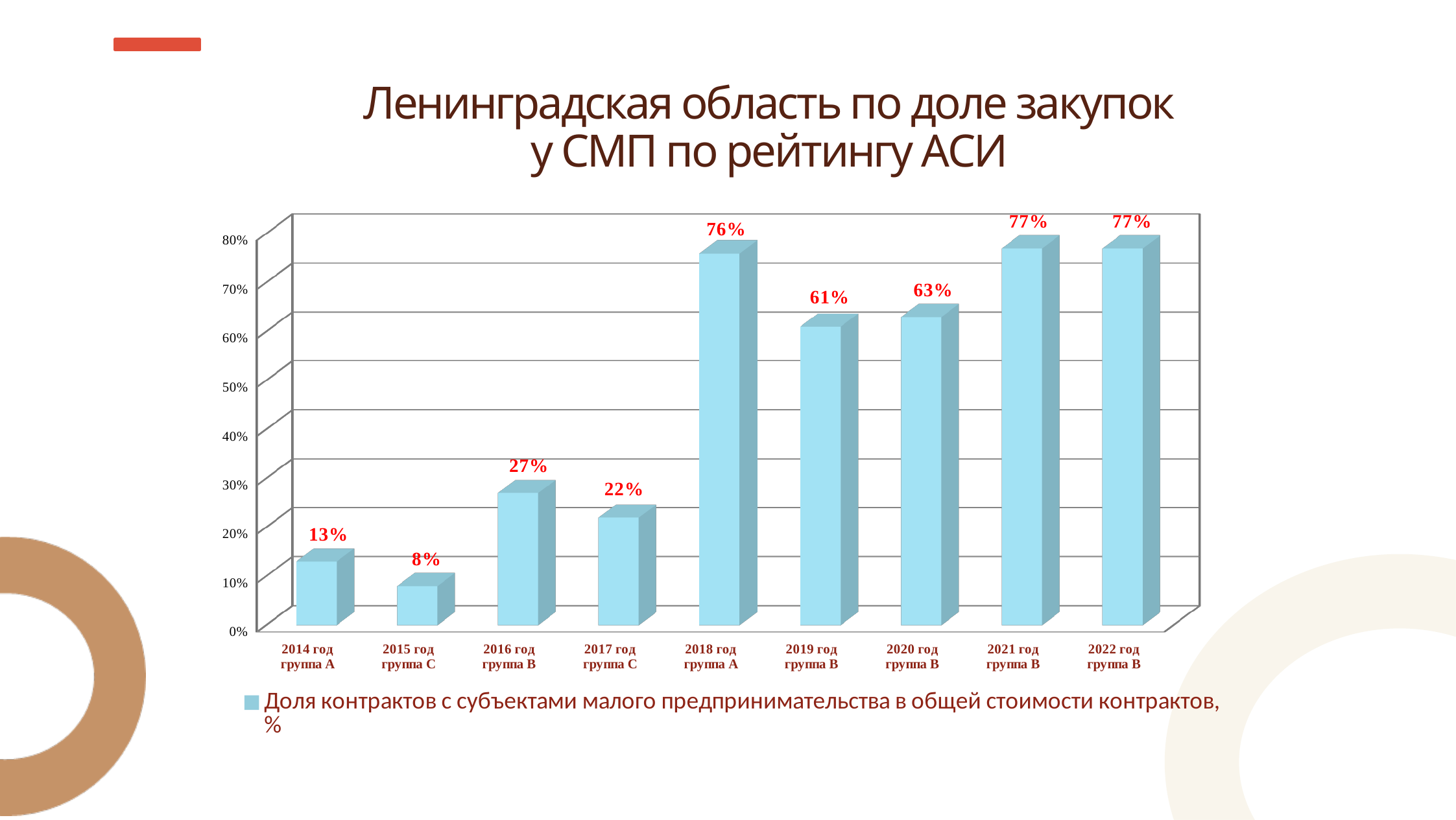
What is the difference between the values for 2016 год and 2015 год? 19% What is the value for 2018 год группа А? 76% Is the value for 2017 год группа С greater or less than 30%? less What is the difference between the values for 2018 год and 2017 год? 54% Which is larger, the value for 2019 год or the value for 2020 год? 2020 год How many bars are shown in the chart? 9 What is the value for 2020 год группа В? 63% Which year has the lowest value? 2015 год группа С What kind of chart is shown on the slide? bar chart What is the value for 2014 год группа А? 13% Do the values generally rise or fall from 2014 to 2022? rise How many series does the legend list? 1